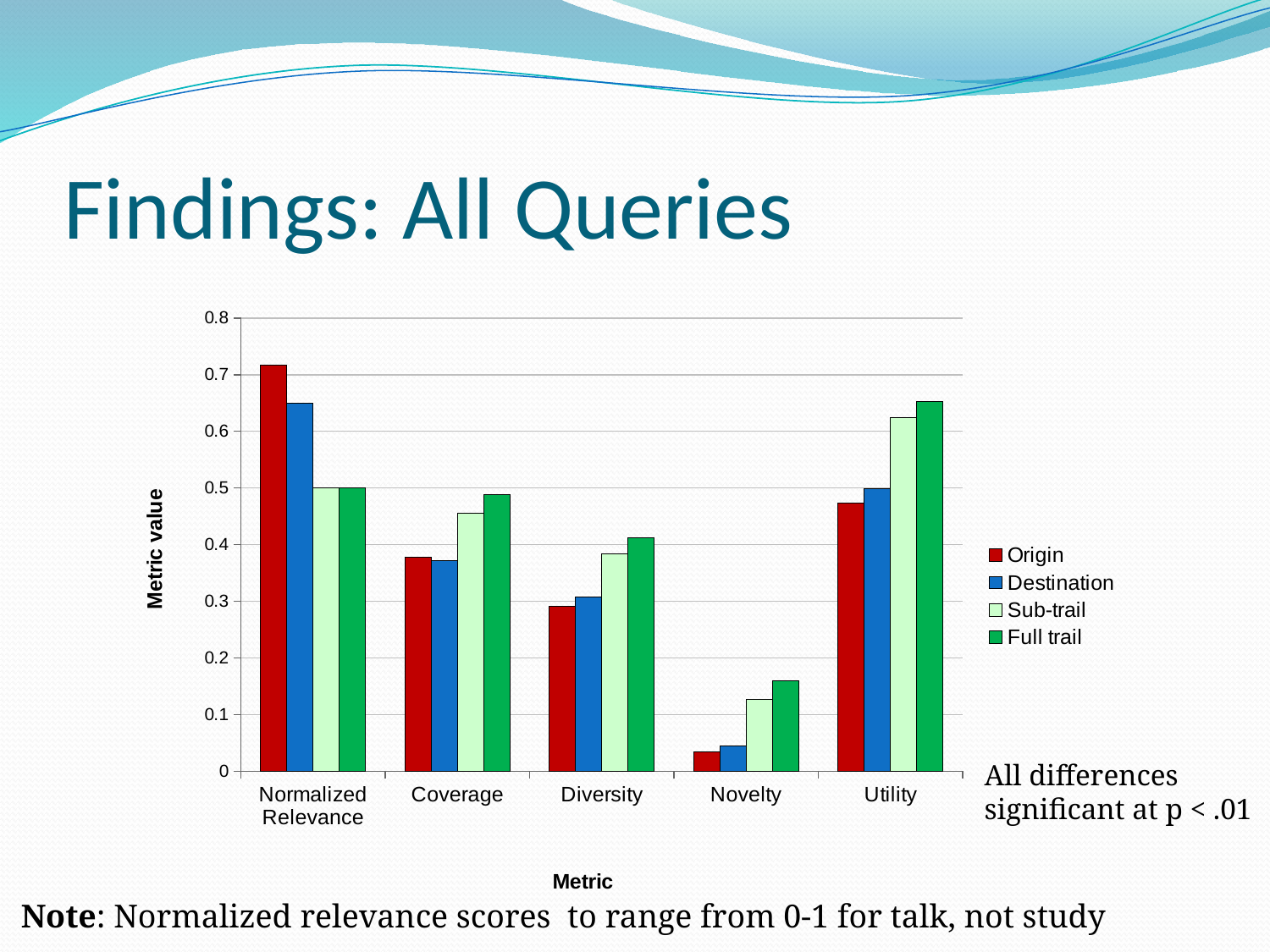
For which metric is the Full trail bar the lowest? Novelty Is the Full trail value for Novelty greater or less than 0.2? less For which metric is the Origin bar the highest? Normalized Relevance What is the title of the y axis? Metric value Is the Sub-trail value for Utility greater or less than 0.6? greater How many metrics are shown along the x axis? 5 What is the title of the x axis? Metric For Normalized Relevance, which is larger: the Origin value or the Destination value? Origin Is the Destination value for Coverage greater or less than 0.4? less For Novelty, which is larger: the Sub-trail value or the Full trail value? Full trail What kind of chart is shown on the slide? bar chart How many series does the legend list? 4